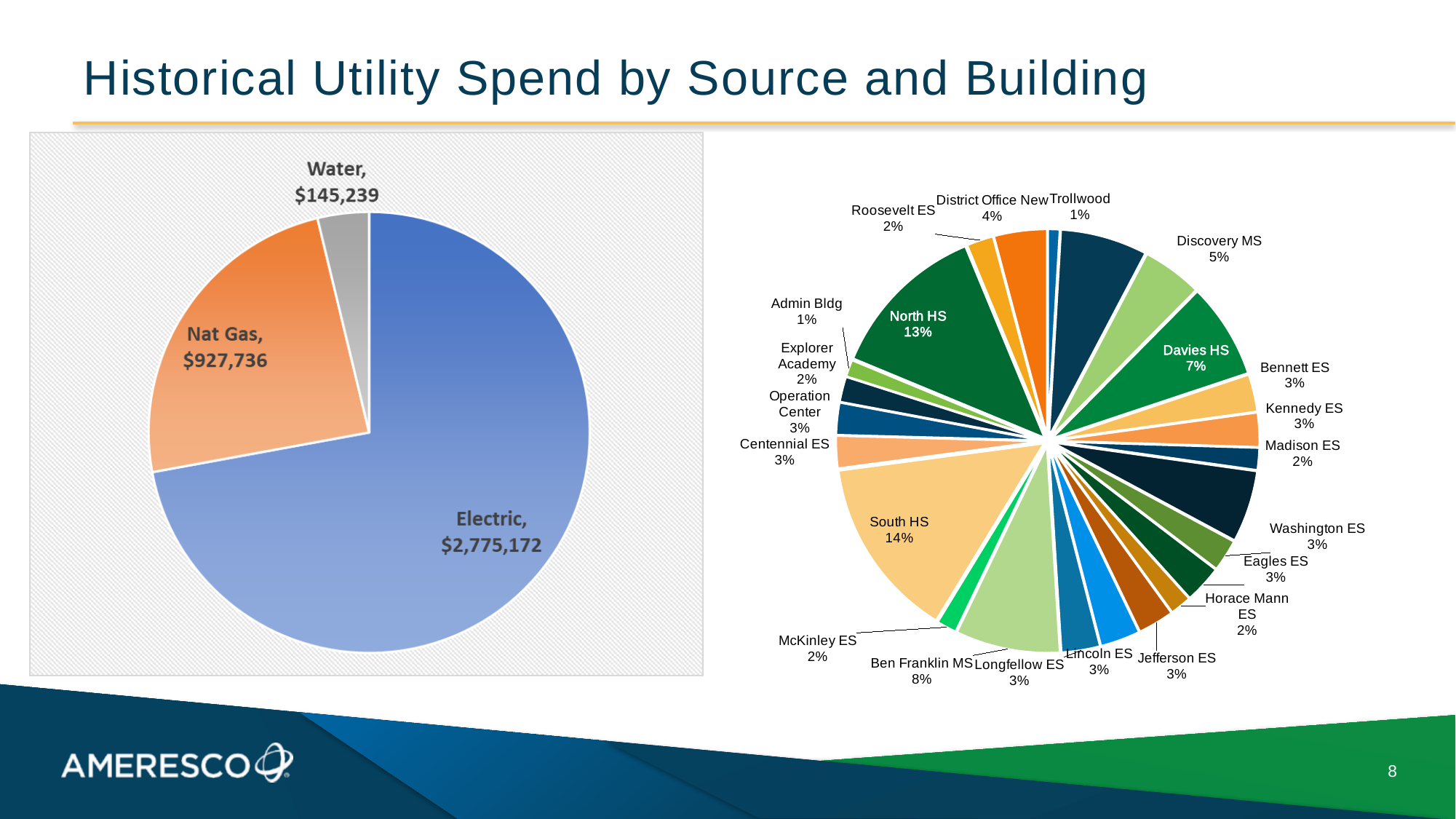
On the right pie chart, what share of spend is North HS? 13% On the left pie chart, what is the spend for Water? $145,239 On the right pie chart, which is larger, Davies HS or Discovery MS? Davies HS On the right pie chart, what share of spend is South HS? 14% On the left pie chart, which source has the lowest spend? Water What kind of chart is the left chart? Pie chart On the right pie chart, which building has the largest share? South HS What is the title of the slide? Historical Utility Spend by Source and Building On the right pie chart, what share of spend is Ben Franklin MS? 8% On the left pie chart, what is the spend for Electric? $2,775,172 On the left pie chart, how many sources are shown? 3 On the left pie chart, what is the difference between the Electric and Nat Gas spend? $1,847,436